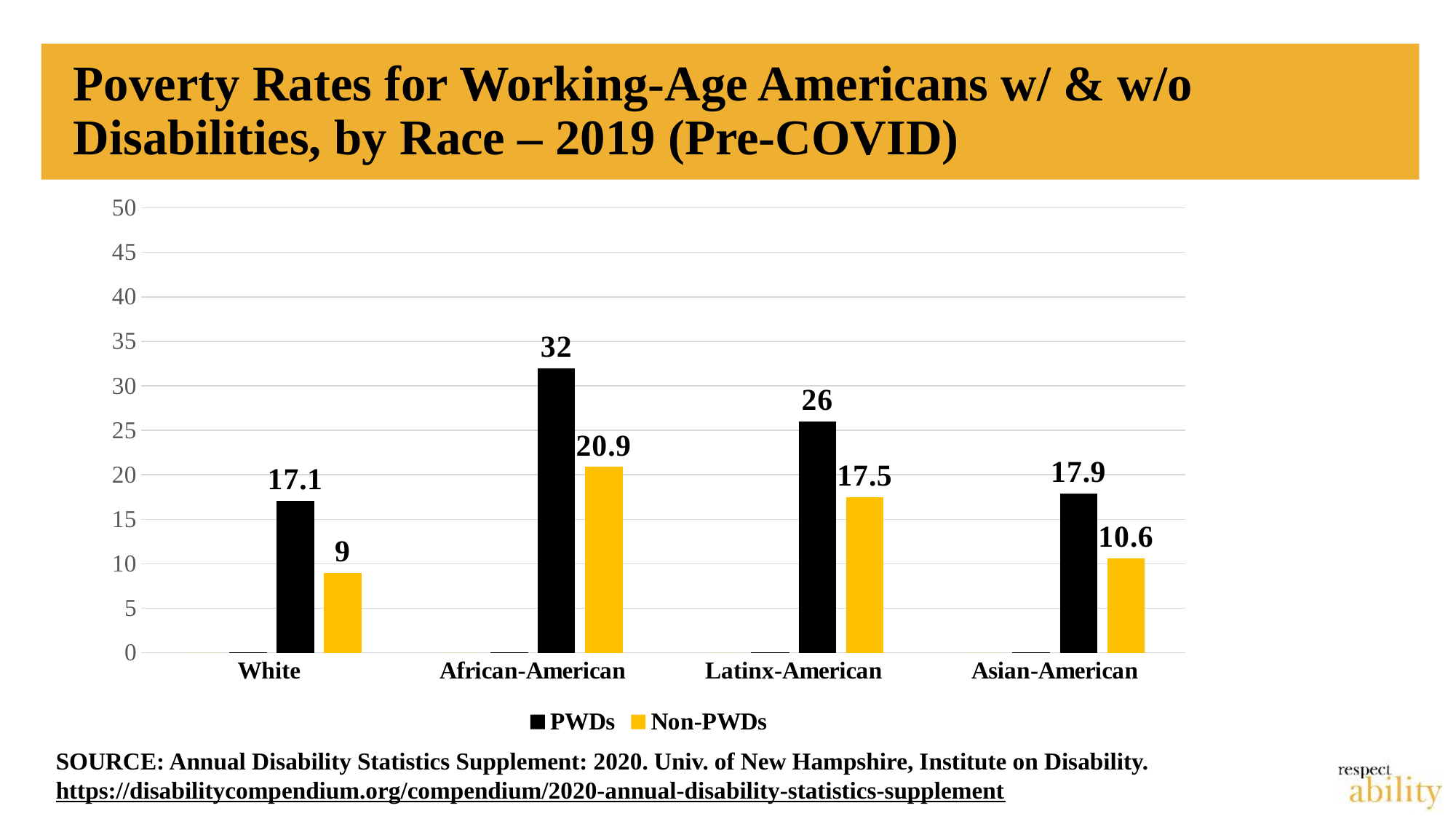
What is the poverty rate for PWDs in the African-American category? 32 How many series does the legend list? 2 What is the difference between the PWDs and Non-PWDs poverty rates for Latinx-Americans? 8.5 What is the difference between the PWDs poverty rates for African-Americans and Whites? 14.9 Is the PWDs poverty rate for Latinx-Americans greater or less than 25? greater What kind of chart is shown on the slide? Bar chart What is the poverty rate for Non-PWDs in the Asian-American category? 10.6 How many race categories are shown on the x axis? 4 Which race category has the highest poverty rate for PWDs? African-American What is the poverty rate for Non-PWDs in the White category? 9 Which is larger: the Non-PWDs rate for African-Americans or the PWDs rate for Asian-Americans? Non-PWDs rate for African-Americans Which race category has the lowest poverty rate for Non-PWDs? White